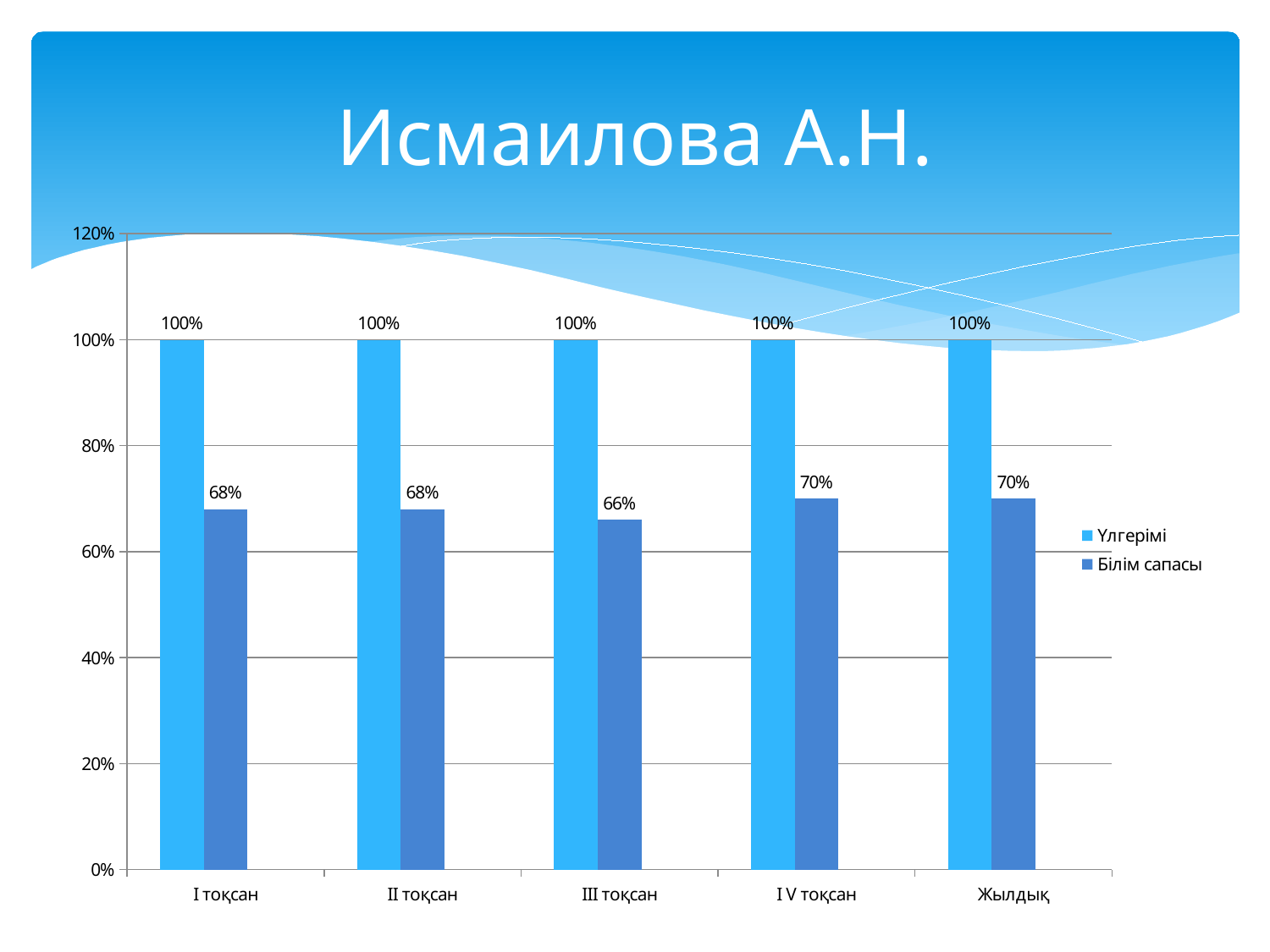
What kind of chart is shown on the slide? Bar chart Which is larger: Білім сапасы for II тоқсан or for IV тоқсан? IV тоқсан How many series does the legend list? 2 What is the value of Білім сапасы for III тоқсан? 66% What is the difference between the Білім сапасы values for IV тоқсан and III тоқсан? 4% What is the value of Үлгерімі for II тоқсан? 100% What is the difference between Үлгерімі and Білім сапасы for I тоқсан? 32% How many categories are shown on the x axis? 5 What is the value of Білім сапасы for Жылдық? 70% Which category has the lowest value for Білім сапасы? III тоқсан Does the Үлгерімі series rise, fall, or stay flat across the categories? Stays flat What is the title of the slide? Исмаилова А.Н.